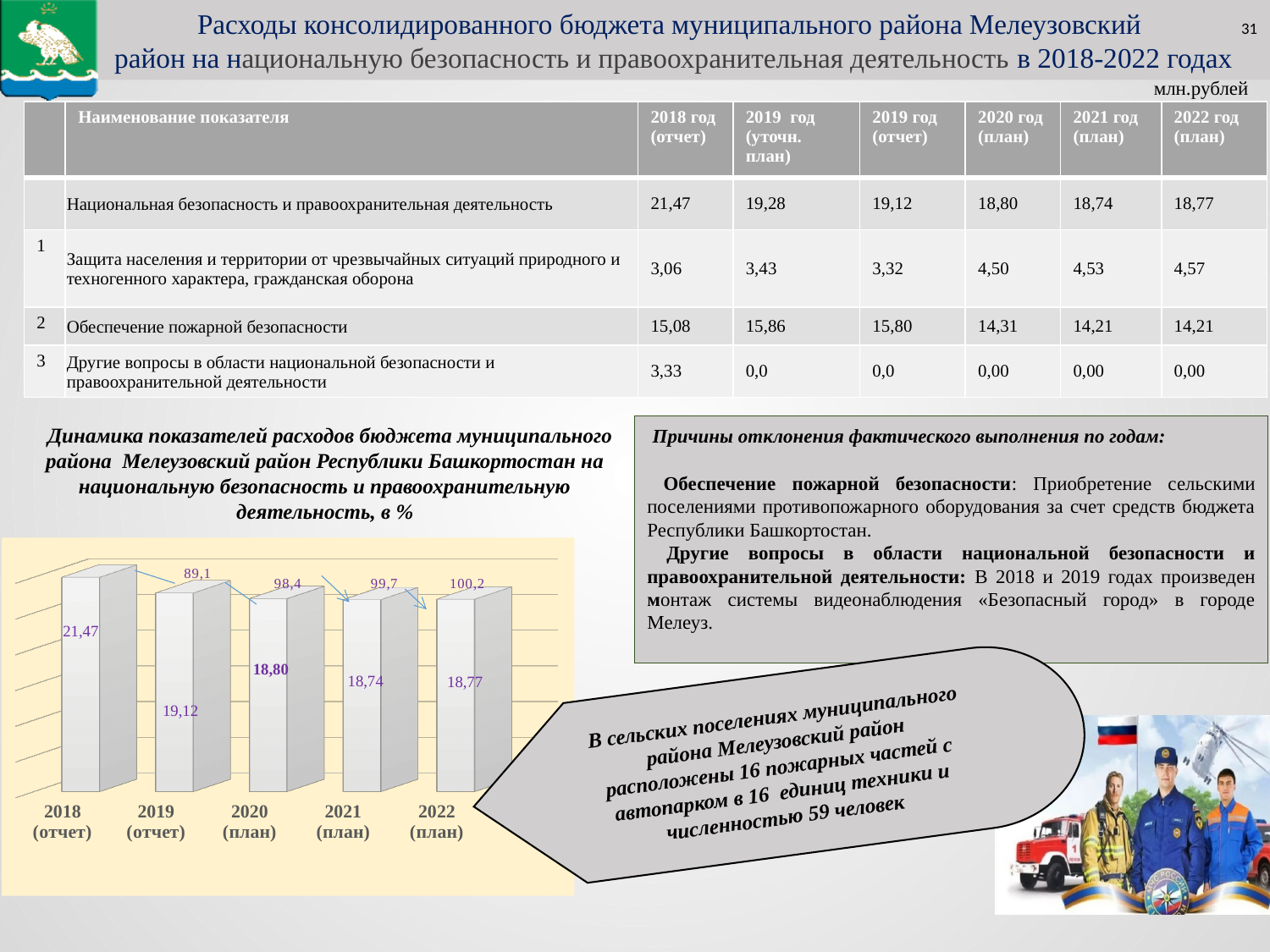
Do the values in the bar chart rise or fall from 2018 (отчет) to 2020 (план)? fall What is the value shown for 2020 (план) in the bar chart? 18,80 What is the value shown for 2022 (план) in the bar chart? 18,77 What is the value shown for 2019 (отчет) in the bar chart? 19,12 Which year has the highest value in the bar chart? 2018 (отчет) How many years (categories) are shown on the x axis of the bar chart? 5 What is the value shown for 2018 (отчет) in the bar chart? 21,47 What kind of chart is shown on the slide? bar chart What is the difference between the values for 2018 (отчет) and 2019 (отчет) in the bar chart? 2,35 Which is larger in the bar chart: the value for 2019 (отчет) or the value for 2020 (план)? 2019 (отчет) What percentage label is shown on the line above the 2019 (отчет) bar? 89,1 What percentage label is shown on the line above the 2022 (план) bar? 100,2